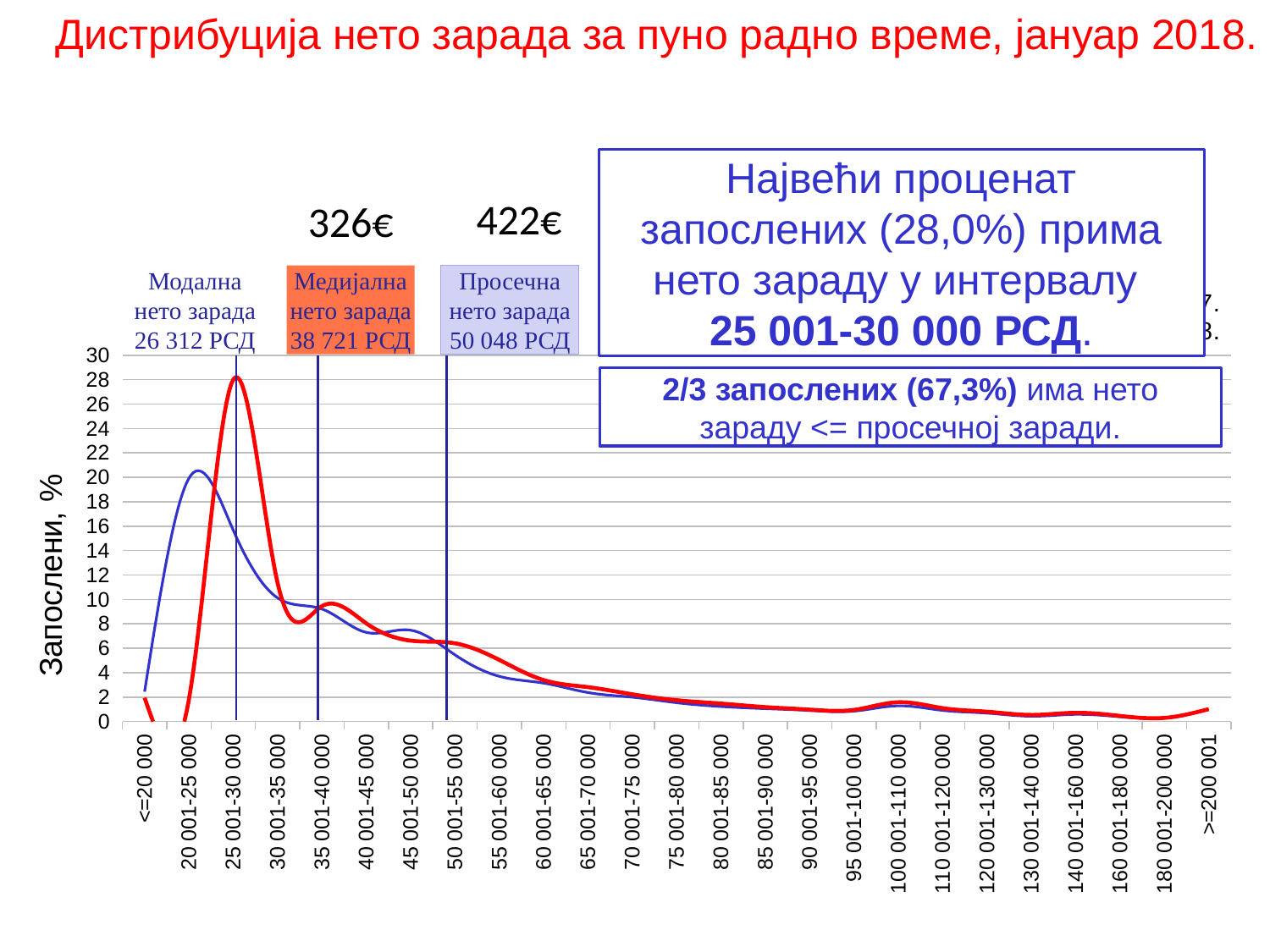
At the interval 25 001-30 000, which line has the larger value, the red line or the blue line? red line Is the value of the red line for the interval 25 001-30 000 greater or less than 26? greater In which earnings interval does the red line reach its highest value? 25 001-30 000 What is the label of the vertical axis? Запослени, % Do the values of the red line generally rise or fall from the interval 25 001-30 000 towards the higher earnings intervals? fall How many earnings intervals are shown on the x axis? 25 What is the title of the chart on the slide? Дистрибуција нето зарада за пуно радно време, јануар 2018. What is the highest percentage of employees shown for the red line, according to the text on the slide? 28,0% Is the value of the red line for the interval 50 001-55 000 greater or less than 8? less Is the value of the blue line for the interval 20 001-25 000 greater or less than 18? greater What kind of chart is shown on the slide? line chart